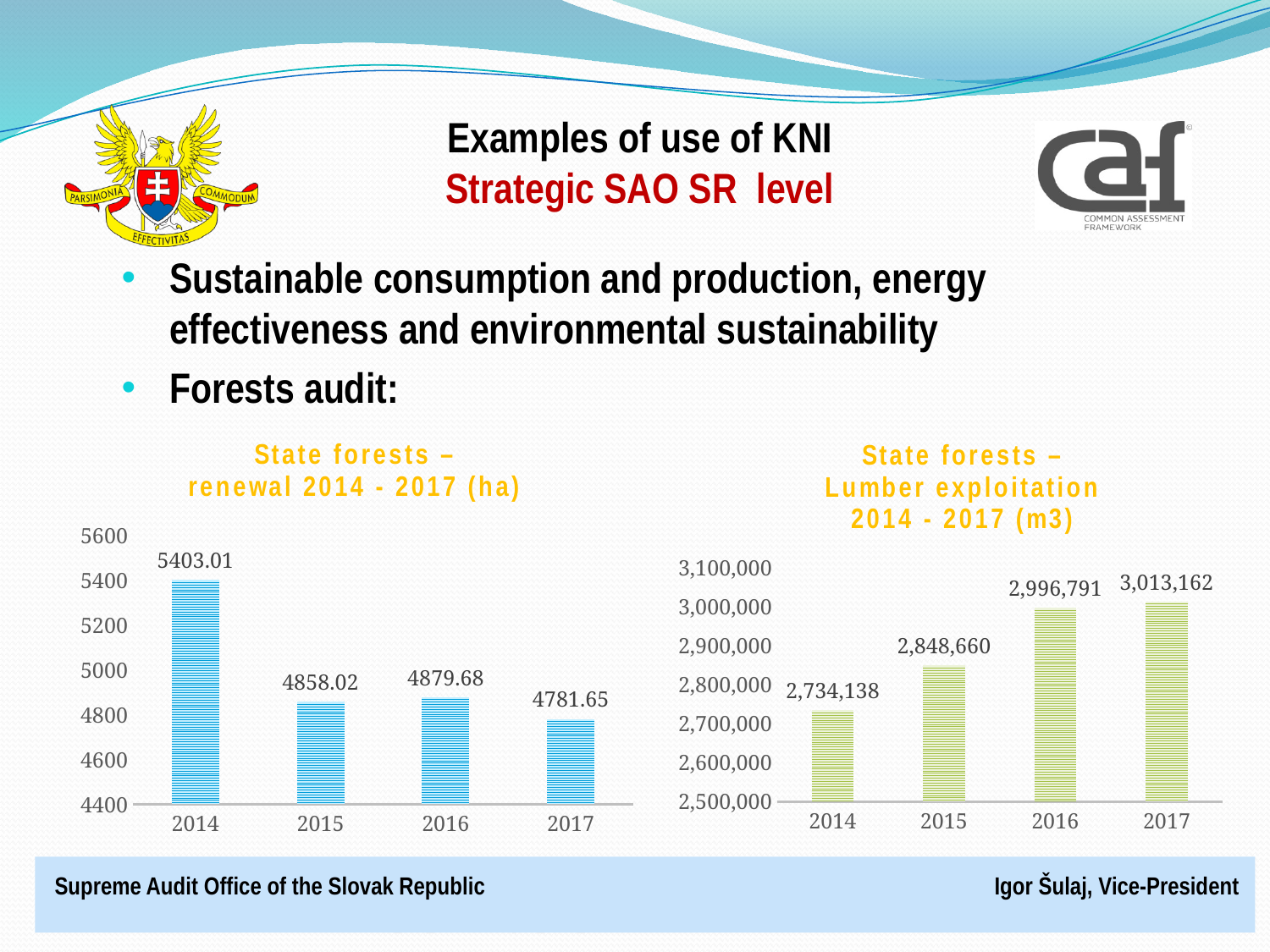
How many years are shown on the x axis of the 'State forests – renewal 2014 - 2017 (ha)' chart? 4 In the 'State forests – renewal 2014 - 2017 (ha)' chart, which is larger, the value for 2015 or the value for 2016? 2016 In the 'State forests – Lumber exploitation 2014 - 2017 (m3)' chart, which year has the highest value? 2017 In the 'State forests – renewal 2014 - 2017 (ha)' chart, which year has the lowest value? 2017 In the 'State forests – Lumber exploitation 2014 - 2017 (m3)' chart, do the values rise or fall from 2014 to 2017? rise In the 'State forests – renewal 2014 - 2017 (ha)' chart, what is the value for 2017? 4781.65 What kind of chart is the 'State forests – Lumber exploitation 2014 - 2017 (m3)' chart? bar chart In the 'State forests – Lumber exploitation 2014 - 2017 (m3)' chart, what is the difference between the 2017 and 2014 values? 279,024 In the 'State forests – Lumber exploitation 2014 - 2017 (m3)' chart, what is the value for 2015? 2,848,660 In the 'State forests – Lumber exploitation 2014 - 2017 (m3)' chart, is the value for 2014 greater or less than 2,800,000? less In the 'State forests – renewal 2014 - 2017 (ha)' chart, what is the difference between the 2014 and 2017 values? 621.36 In the 'State forests – renewal 2014 - 2017 (ha)' chart, what is the value for 2014? 5403.01